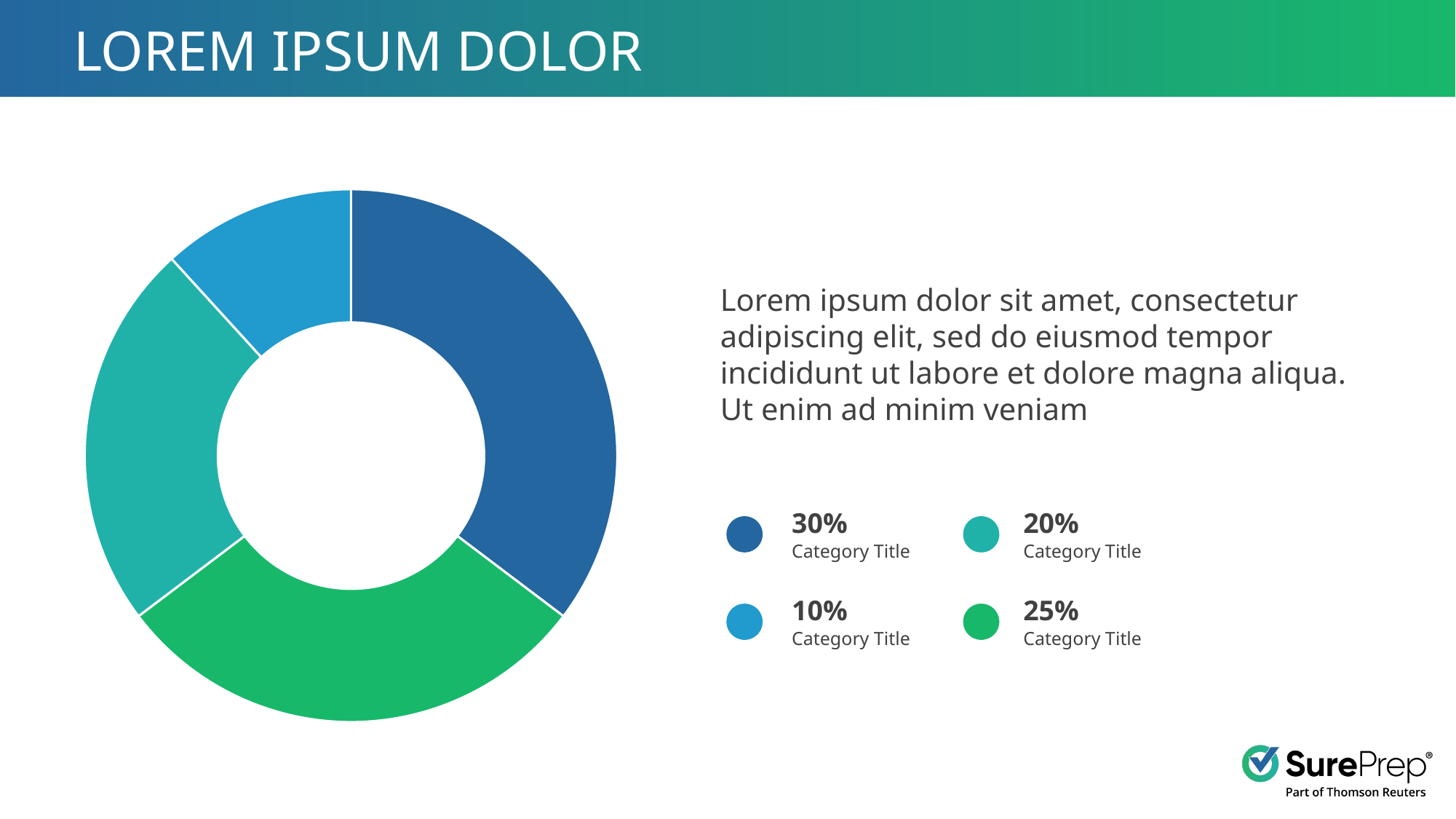
What kind of chart is shown on the slide? Donut chart Which colour slice has the smallest share in the donut chart? Light blue How many entries does the legend next to the donut chart list? 4 What percentage is shown for the light blue slice of the donut chart? 10% Which colour slice has the largest share in the donut chart? Dark blue What percentage is shown for the green slice of the donut chart? 25% What percentage is shown for the teal slice of the donut chart? 20% Which is larger in the donut chart, the green slice or the teal slice? Green What is the difference between the dark blue slice's percentage and the light blue slice's percentage? 20% What share of the donut does the green slice represent according to the legend? 25% How many slices does the donut chart have? 4 What percentage is shown for the dark blue slice of the donut chart? 30%